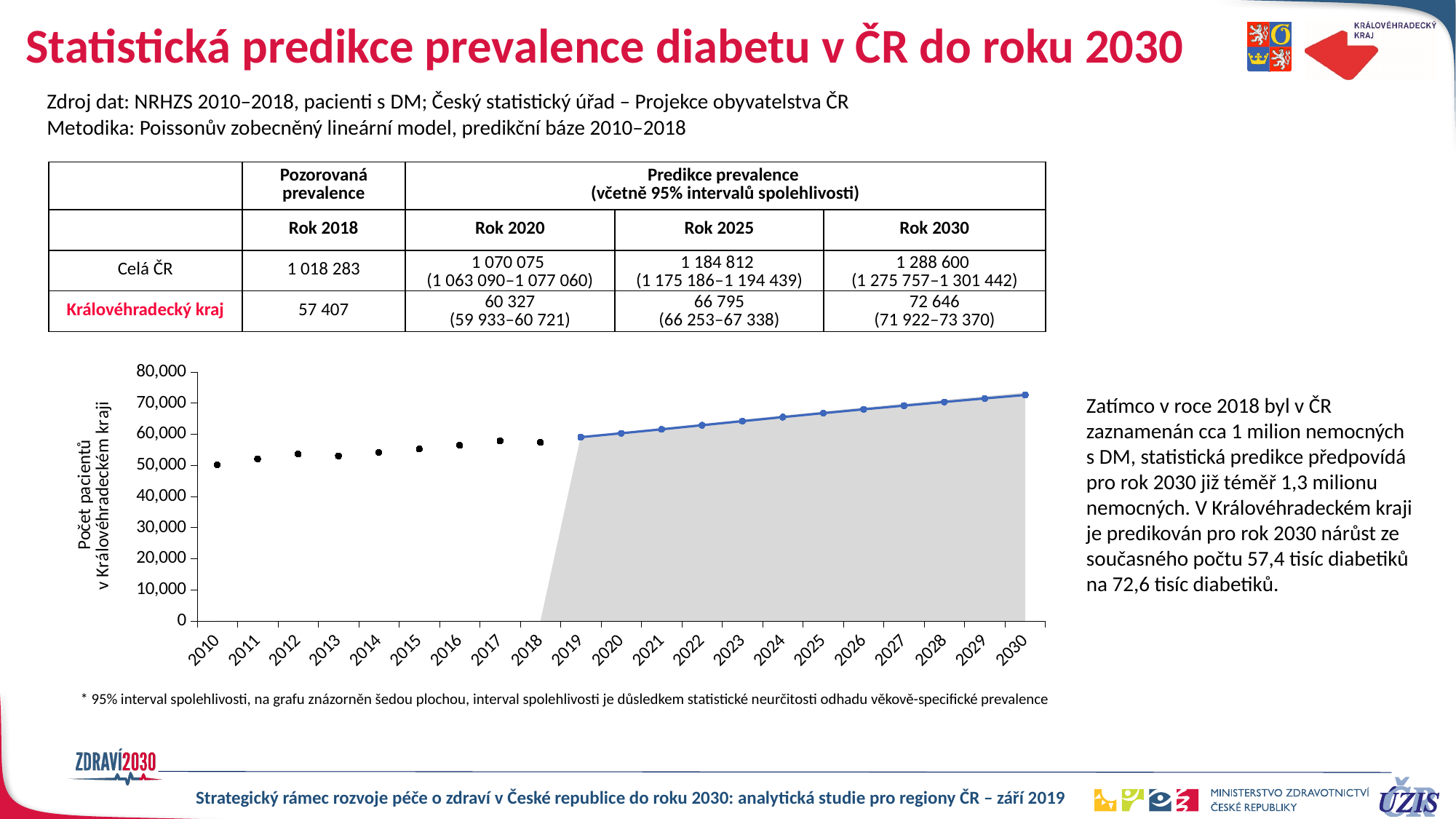
Do the values in the chart rise or fall from 2010 to 2030? rise Is the value for 2024 greater or less than 60,000? greater What does the grey area in the chart represent? 95% interval spolehlivosti Is the value for 2030 larger than the value for 2018? yes Which year has the highest value in the chart? 2030 Is the value for 2030 greater or less than 70,000? greater How many years are shown on the x axis of the chart? 21 Is the value for 2010 greater or less than 40,000? greater What is the label of the y axis of the chart? Počet pacientů v Královéhradeckém kraji Which year has the lowest value in the chart? 2010 What kind of chart is shown on the slide? line chart